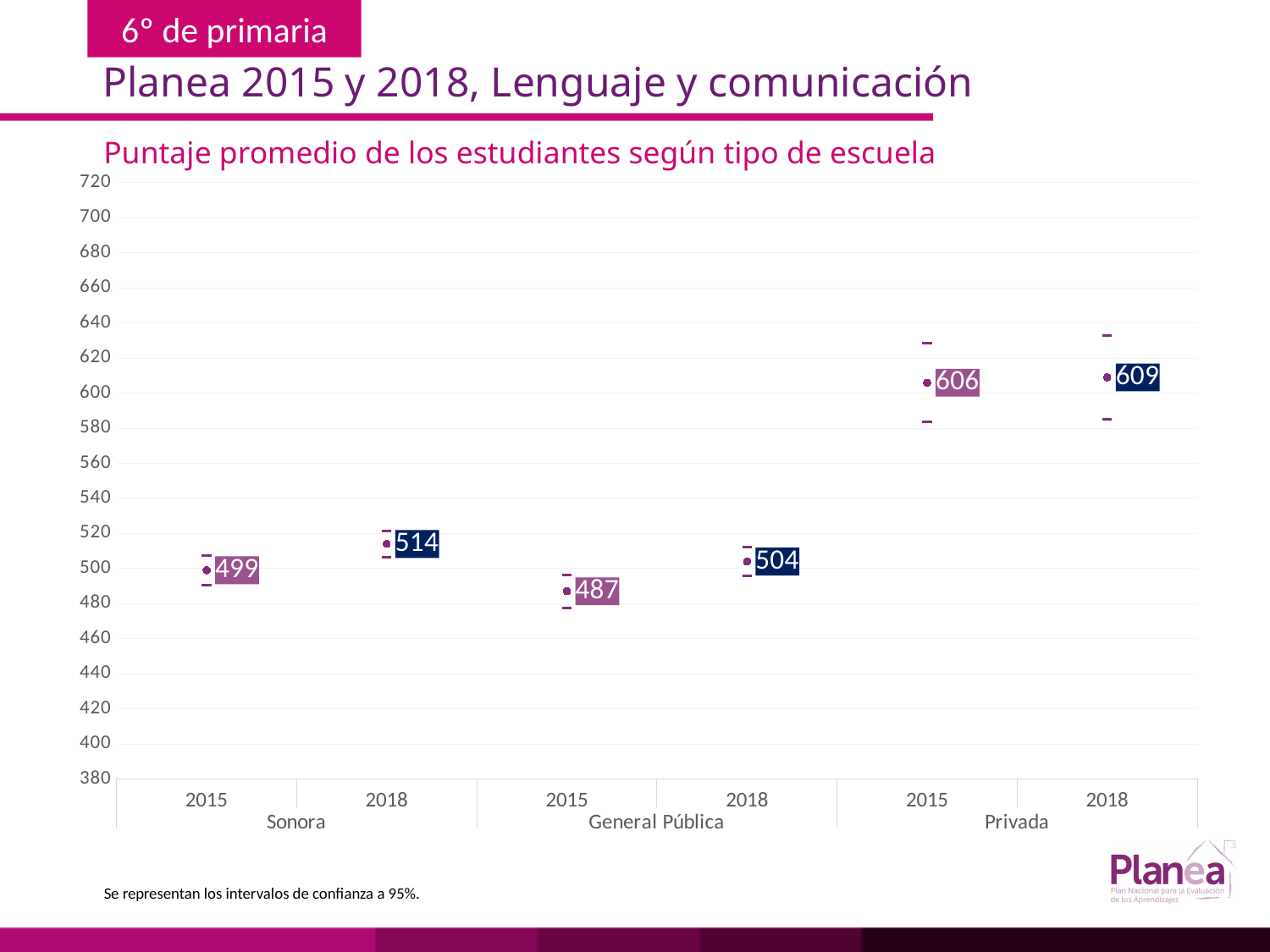
What is the average score for Privada in 2018? 609 Which group and year has the highest average score? Privada 2018 What is the difference between the General Pública scores in 2018 and 2015? 17 How many data points are plotted on the chart? 6 Which is larger, the Sonora 2018 score or the General Pública 2018 score? Sonora 2018 By how many points did the Sonora average score change from 2015 to 2018? 15 What is the average score for Sonora in 2018? 514 What is the title of the chart? Puntaje promedio de los estudiantes según tipo de escuela Did the Privada average score rise or fall from 2015 to 2018? rise What is the average score for General Pública in 2015? 487 Which group and year has the lowest average score? General Pública 2015 What is the average score for Sonora in 2015? 499